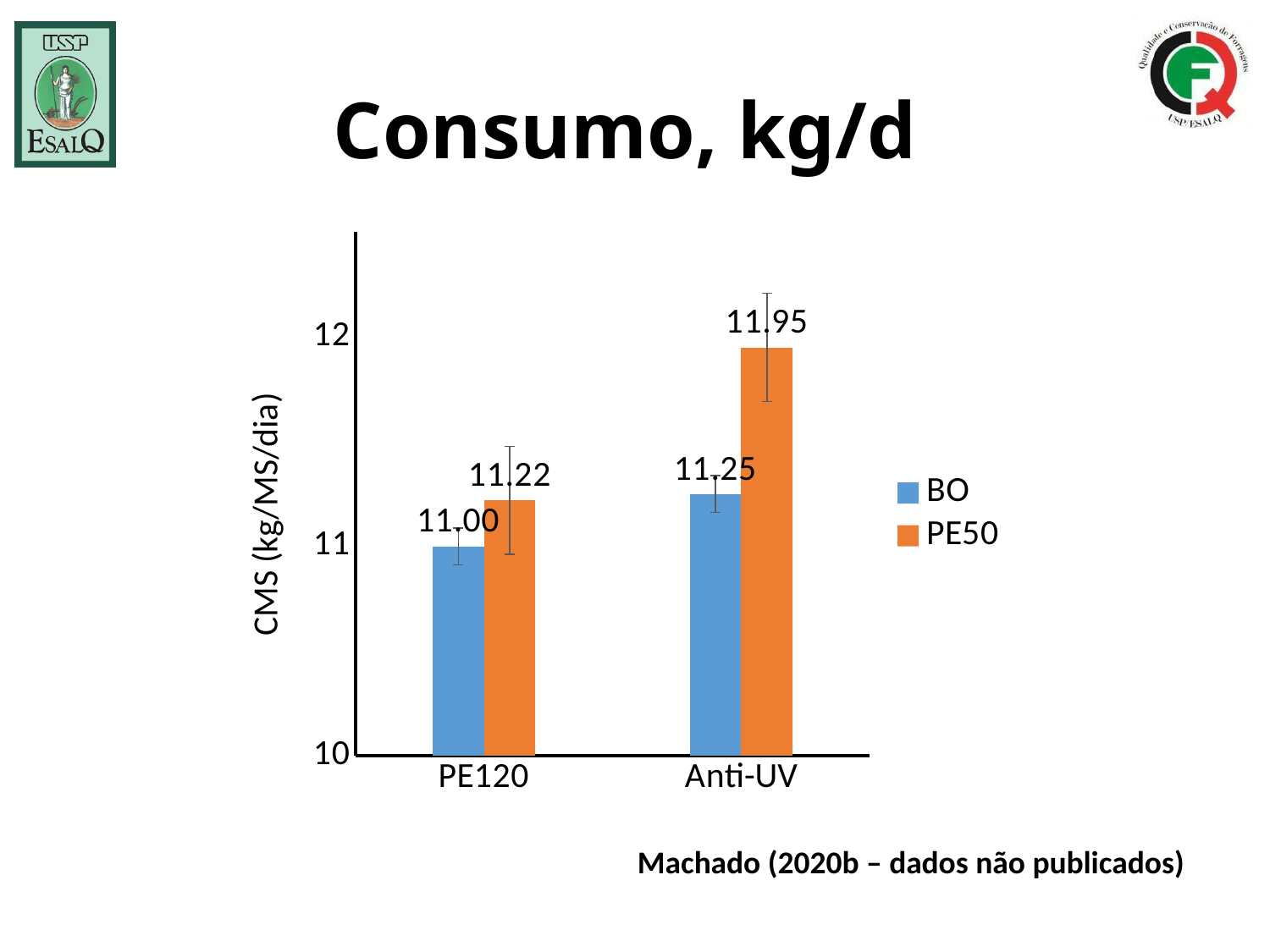
Which is larger in the PE120 category, BO or PE50? PE50 What is the value for BO in the PE120 category? 11.00 What kind of chart is shown on the slide? Bar chart How many series does the legend list? 2 What is the difference between PE50 and BO in the Anti-UV category? 0.70 How many categories are shown on the x axis? 2 What is the label of the y axis? CMS (kg/MS/dia) What is the value for BO in the Anti-UV category? 11.25 What is the value for PE50 in the Anti-UV category? 11.95 Which bar has the lowest value on the chart? BO in PE120 What is the value for PE50 in the PE120 category? 11.22 Which bar has the highest value on the chart? PE50 in Anti-UV